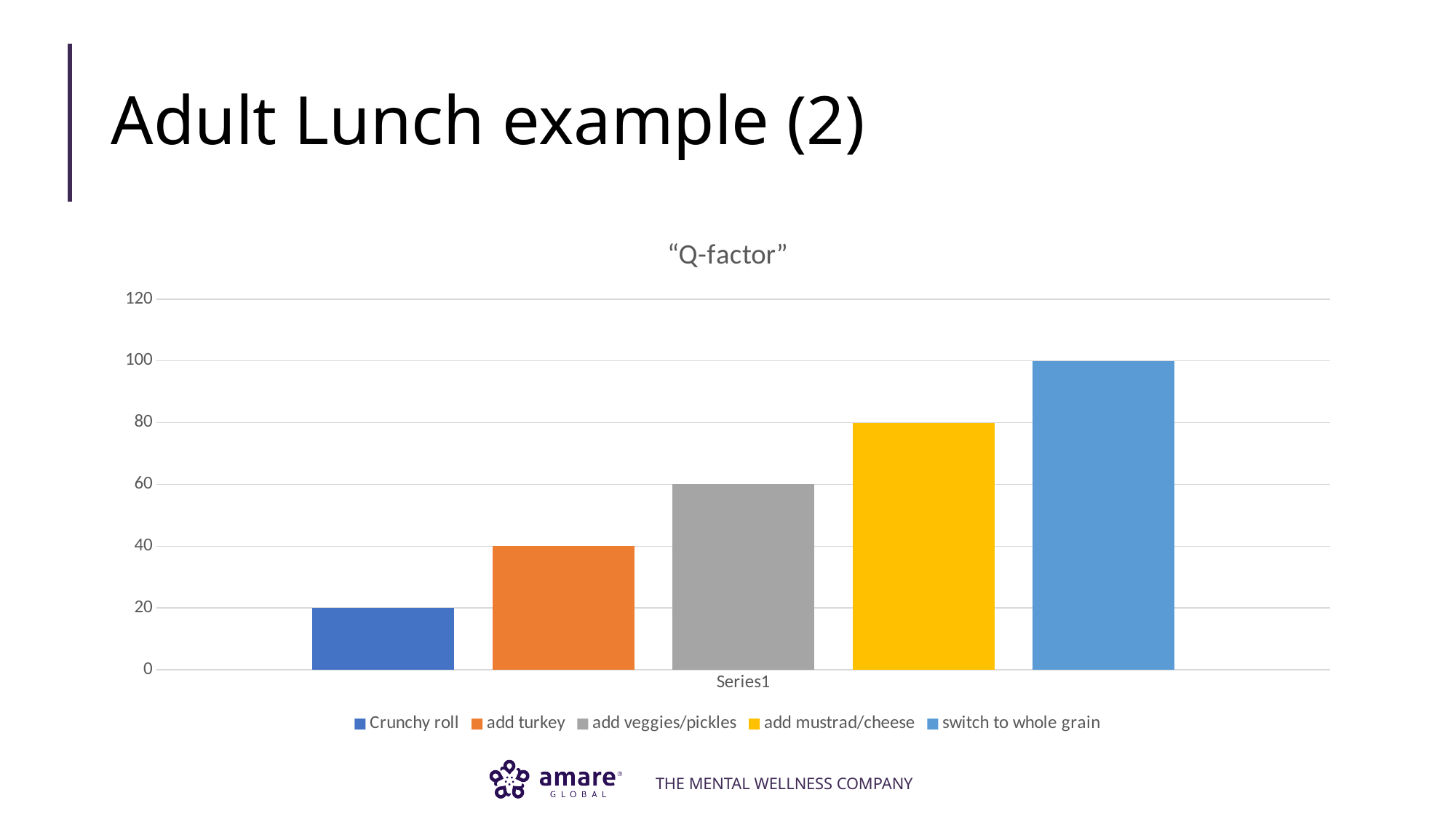
How many series does the legend list? 5 Which is larger, the value for add turkey or the value for add mustrad/cheese? add mustrad/cheese Which series has the lowest value? Crunchy roll What is the value for Crunchy roll? 20 What is the value for add turkey? 40 What kind of chart is shown on the slide? bar chart What is the value for add mustrad/cheese? 80 Which series has the highest value? switch to whole grain What is the value for add veggies/pickles? 60 What is the difference between the values for switch to whole grain and Crunchy roll? 80 What is the title of the chart? "Q-factor" What is the value for switch to whole grain? 100